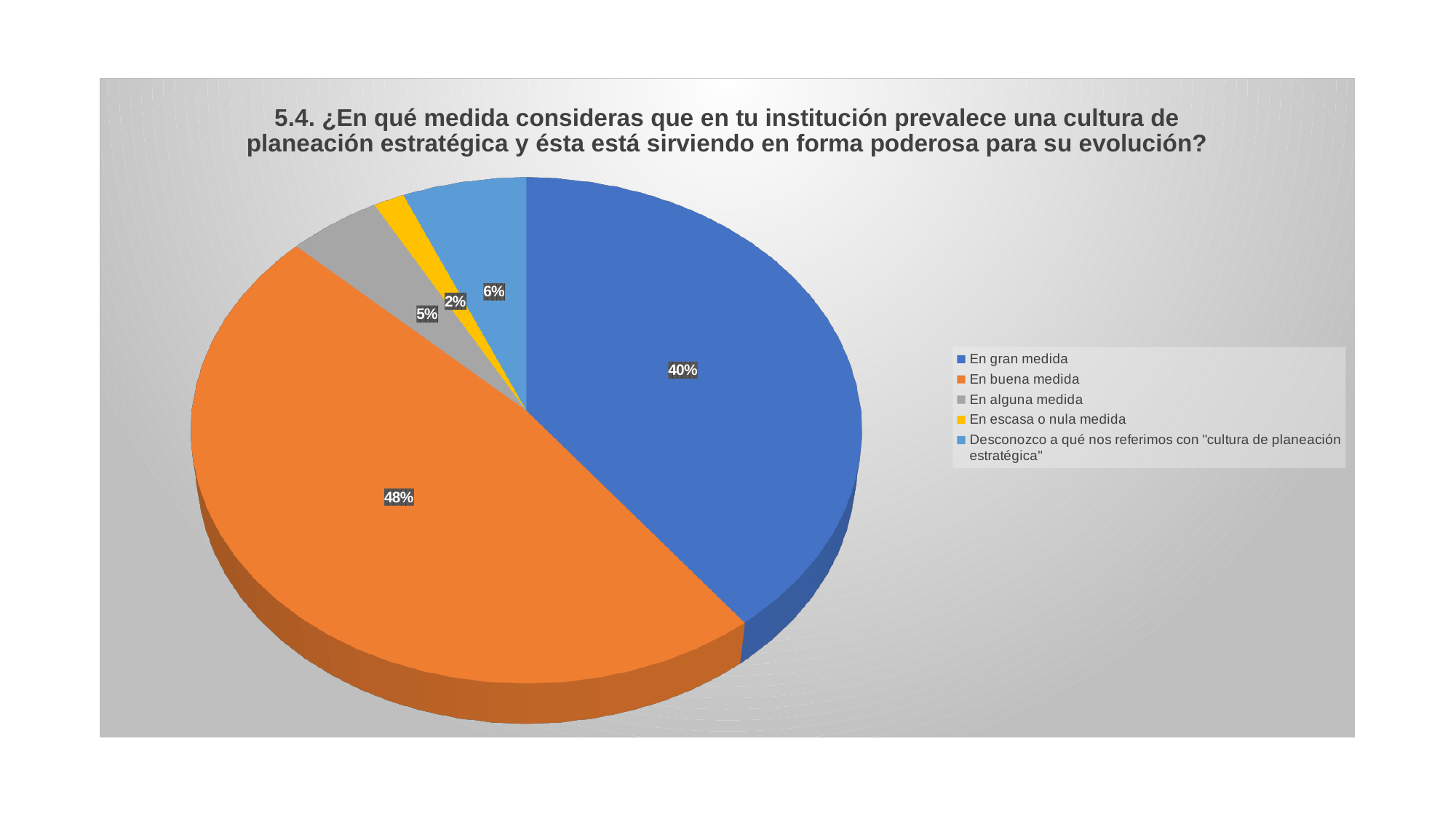
How many categories does the legend list? 5 What colour is the slice for "En escasa o nula medida"? yellow What is the value for "Desconozco a qué nos referimos con "cultura de planeación estratégica""? 6% What is the difference between the values for "En buena medida" and "En gran medida"? 8% Which is larger, the slice for "En alguna medida" or the slice for "Desconozco a qué nos referimos con "cultura de planeación estratégica""? Desconozco a qué nos referimos con "cultura de planeación estratégica" Which category has the smallest slice of the pie? En escasa o nula medida Which category has the largest slice of the pie? En buena medida What kind of chart is shown on the slide? pie chart What share of the pie does "En gran medida" represent? 40% What is the value for "En alguna medida"? 5% What is the value for "En escasa o nula medida"? 2% What share of the pie does "En buena medida" represent? 48%